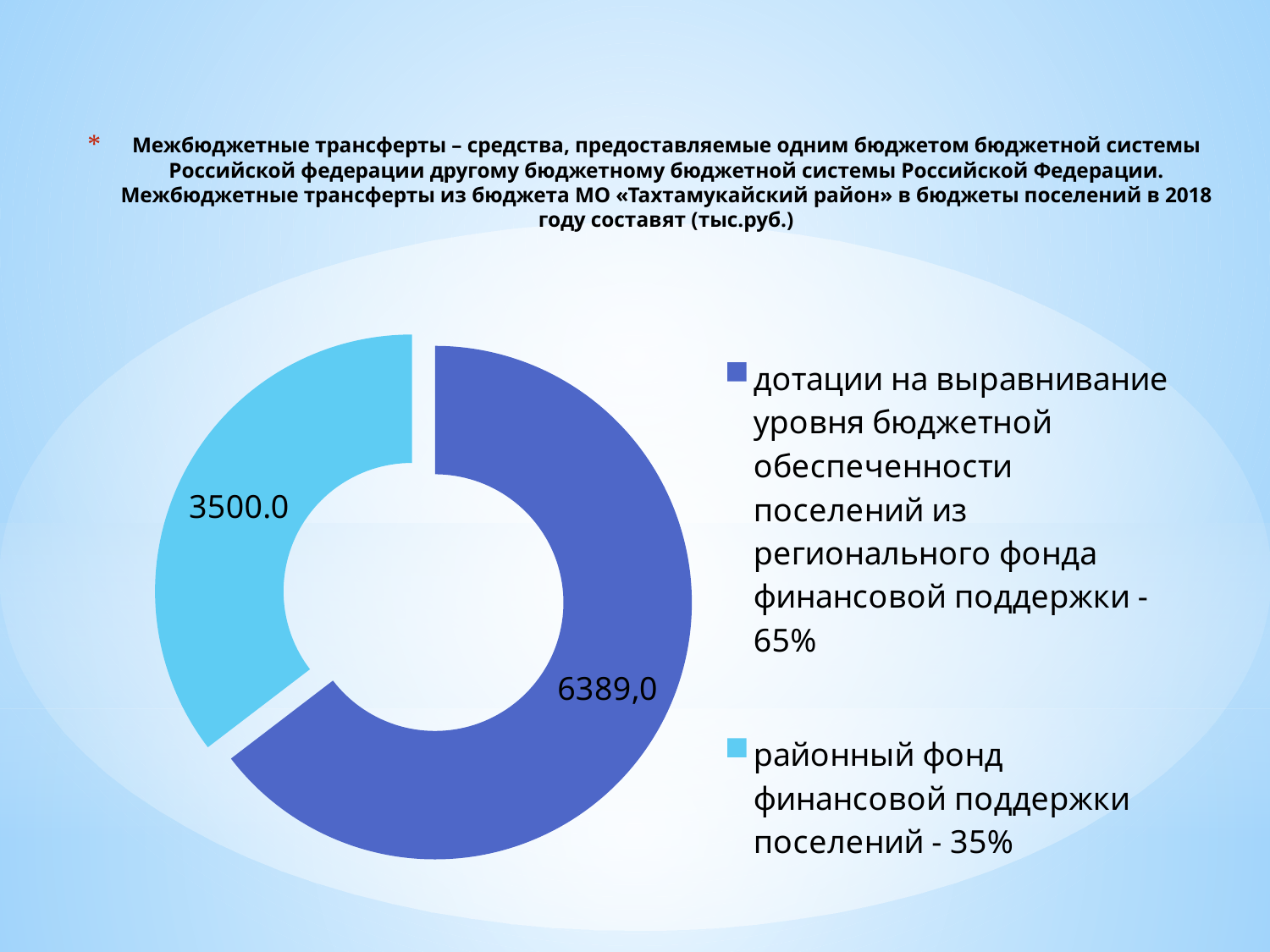
Which category has the smallest slice in the chart? районный фонд финансовой поддержки поселений How many entries does the legend list? 2 How many slices does the chart have? 2 What kind of chart is shown on the slide? doughnut (pie) chart Which is larger: the value for 'дотации на выравнивание...' or the value for 'районный фонд финансовой поддержки поселений'? дотации на выравнивание... What value is shown for the slice 'районный фонд финансовой поддержки поселений'? 3500.0 Which category has the largest slice in the chart? дотации на выравнивание уровня бюджетной обеспеченности поселений из регионального фонда финансовой поддержки What share of the total does 'районный фонд финансовой поддержки поселений' represent, according to the legend? 35% What is the difference between the two slice values (6389,0 and 3500.0)? 2889 What value is shown for the slice 'дотации на выравнивание уровня бюджетной обеспеченности поселений из регионального фонда финансовой поддержки'? 6389,0 What colour is the slice for 'районный фонд финансовой поддержки поселений'? light blue What share of the total does 'дотации на выравнивание уровня бюджетной обеспеченности поселений' represent, according to the legend? 65%